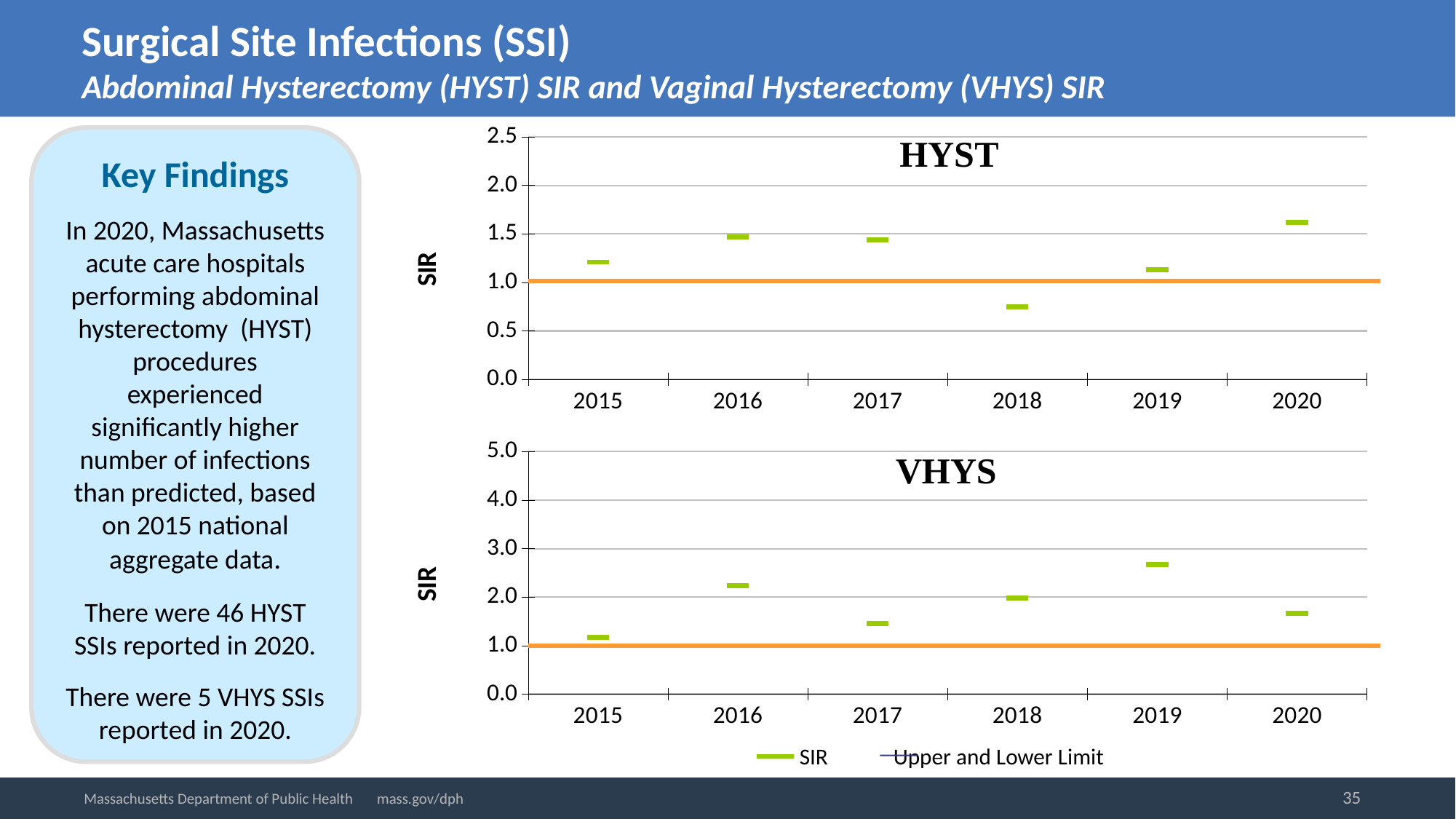
In the HYST chart, which year has the lowest SIR? 2018 In the HYST chart, is the SIR for 2020 greater or less than 1.5? greater In the VHYS chart, which year has the highest SIR? 2019 In the VHYS chart, is the SIR for 2016 greater or less than 2.0? greater How many series does the legend below the VHYS chart list? 2 In the VHYS chart, is the SIR for 2017 greater or less than 2.0? less In the HYST chart, which is larger, the SIR for 2016 or the SIR for 2018? 2016 In the HYST chart, which year has the highest SIR? 2020 In the VHYS chart, which is larger, the SIR for 2019 or the SIR for 2015? 2019 In the VHYS chart, which year has the lowest SIR? 2015 How many years are plotted on the x axis of the HYST chart? 6